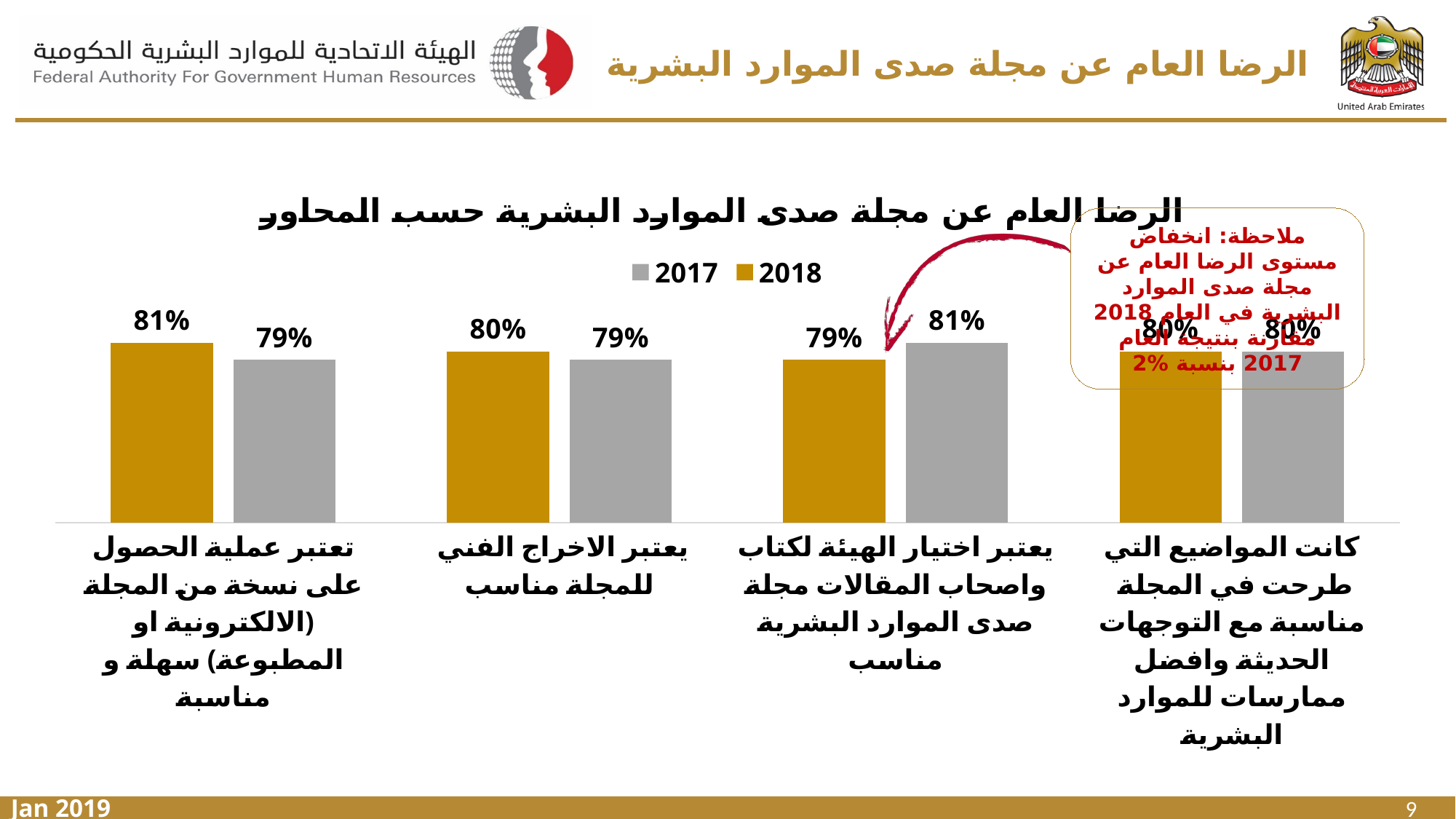
How many series does the chart legend list? 2 What type of chart is shown on the slide? Bar chart Which colour represents the 2018 series in the chart? Gold How many categories are shown on the x axis of the chart? 4 What is the 2017 value for the category 'يعتبر الاخراج الفني للمجلة مناسب'? 79% What is the difference between the 2018 and 2017 values for the category 'تعتبر عملية الحصول على نسخة من المجلة (الالكترونية او المطبوعة) سهلة و مناسبة'? 2% What is the 2017 value for the category 'يعتبر اختيار الهيئة لكتاب واصحاب المقالات مجلة صدى الموارد البشرية مناسب'? 81% Which category has the lowest 2018 value? يعتبر اختيار الهيئة لكتاب واصحاب المقالات مجلة صدى الموارد البشرية مناسب Which category has the highest 2018 value? تعتبر عملية الحصول على نسخة من المجلة (الالكترونية او المطبوعة) سهلة و مناسبة What is the 2018 value for the category 'تعتبر عملية الحصول على نسخة من المجلة (الالكترونية او المطبوعة) سهلة و مناسبة'? 81% For the category 'يعتبر اختيار الهيئة لكتاب واصحاب المقالات مجلة صدى الموارد البشرية مناسب', which year has the larger value, 2017 or 2018? 2017 What is the 2018 value for the category 'يعتبر اختيار الهيئة لكتاب واصحاب المقالات مجلة صدى الموارد البشرية مناسب'? 79%